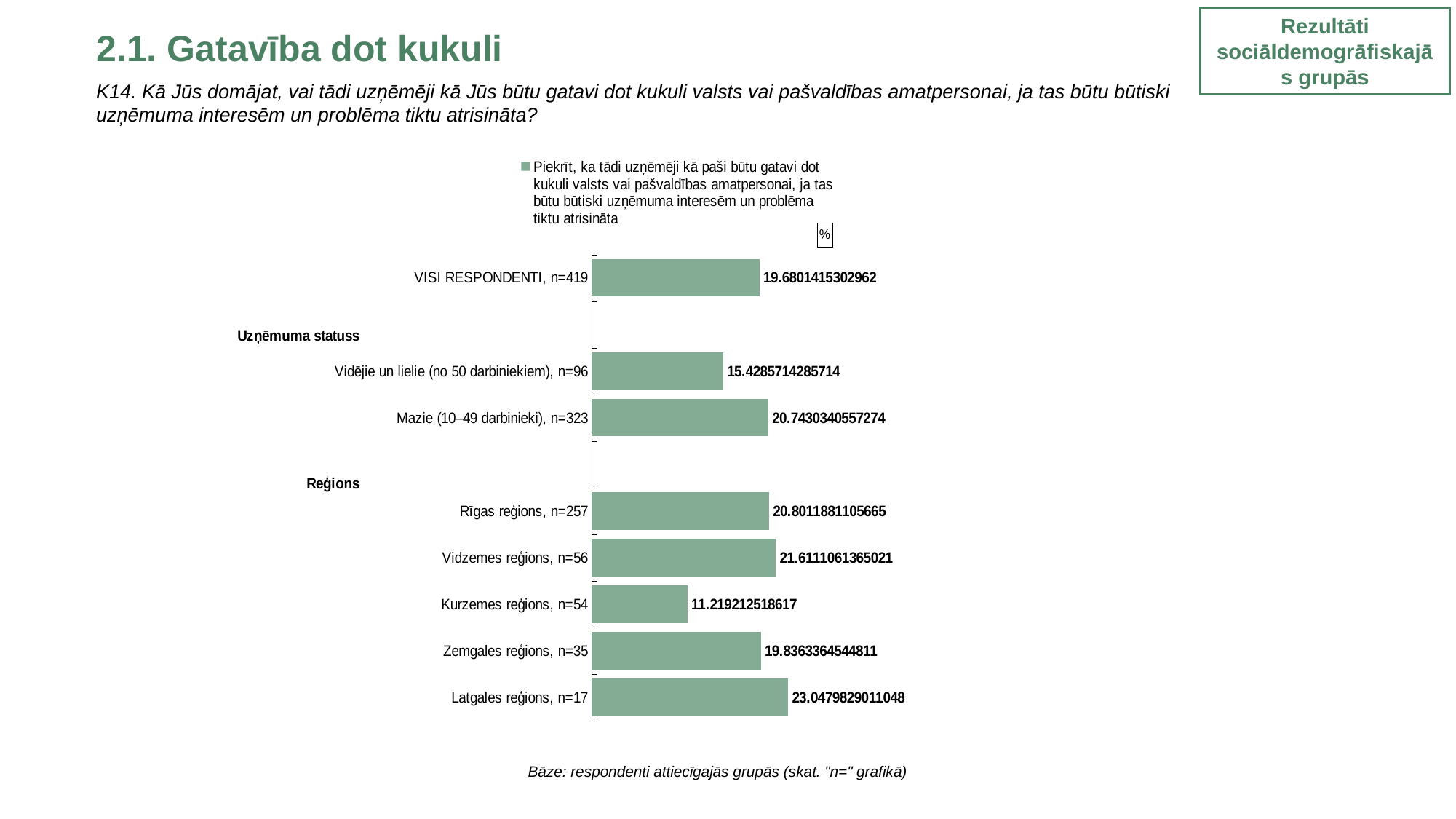
What type of chart is shown on the slide? bar chart What is the value for VISI RESPONDENTI, n=419? 19.6801415302962 Which has a larger value: Vidzemes reģions, n=56 or Zemgales reģions, n=35? Vidzemes reģions, n=56 How many bars are plotted in the chart? 8 Which category has the highest value? Latgales reģions, n=17 What is the value for Latgales reģions, n=17? 23.0479829011048 Which has a larger value: Mazie (10–49 darbinieki), n=323 or Vidējie un lielie (no 50 darbiniekiem), n=96? Mazie (10–49 darbinieki), n=323 What is the value for Kurzemes reģions, n=54? 11.219212518617 How many series does the legend list? 1 What colour are the bars in the chart? green What is the value for Vidējie un lielie (no 50 darbiniekiem), n=96? 15.4285714285714 Which category has the lowest value? Kurzemes reģions, n=54